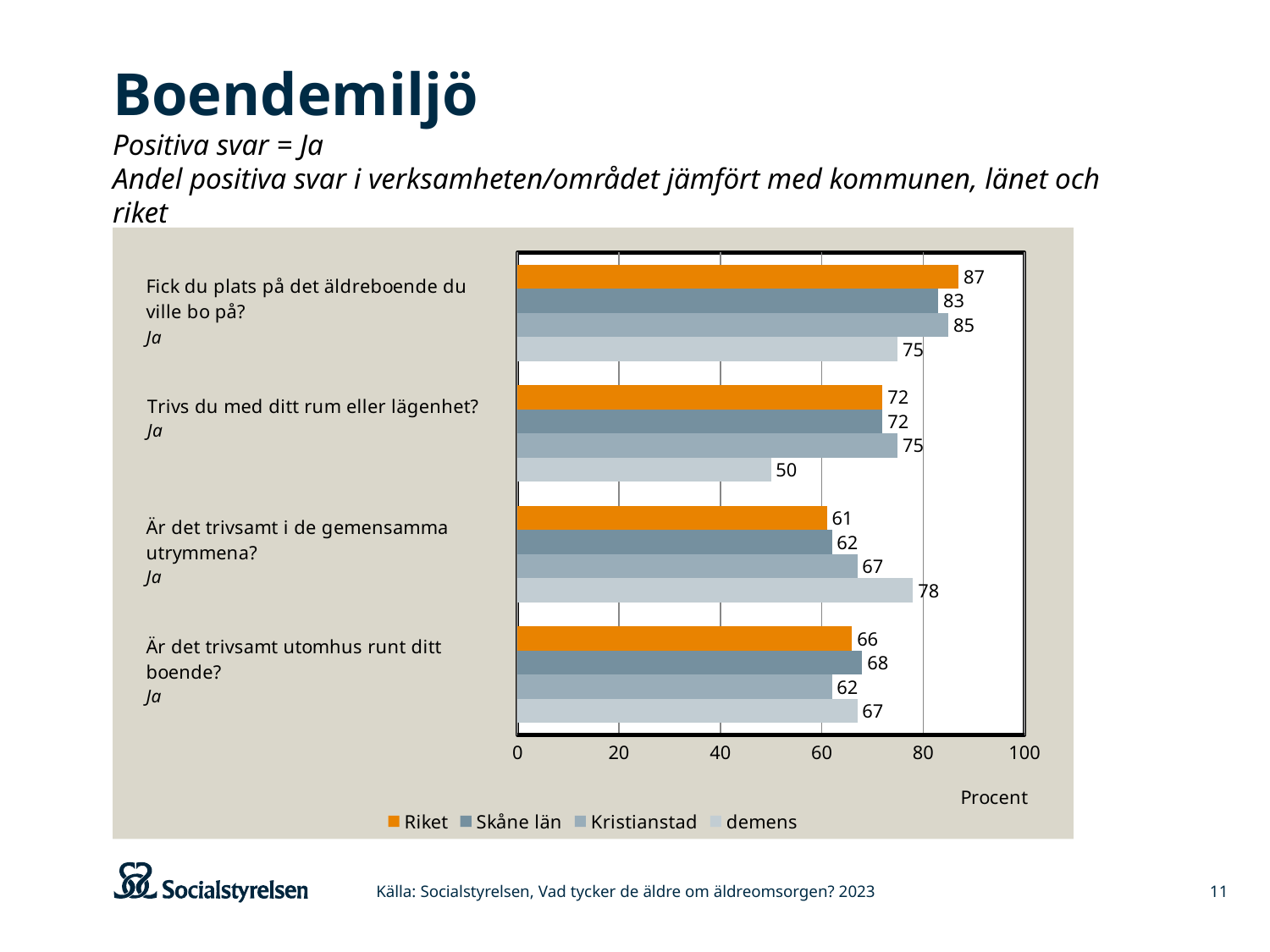
How many series does the legend list? 4 What is the value for Kristianstad for "Är det trivsamt i de gemensamma utrymmena?"? 67 What is the label on the horizontal axis of the chart? Procent How many question categories are plotted on the chart? 4 For "Är det trivsamt utomhus runt ditt boende?", which is larger: the value for Skåne län or the value for Kristianstad? Skåne län Which series has the lowest value for "Trivs du med ditt rum eller lägenhet?"? demens What kind of chart is shown on the slide? bar chart Which series has the highest value for "Är det trivsamt i de gemensamma utrymmena?"? demens What is the difference between the Riket and demens values for "Fick du plats på det äldreboende du ville bo på?"? 12 What is the value for demens for "Trivs du med ditt rum eller lägenhet?"? 50 What is the value for Riket for "Fick du plats på det äldreboende du ville bo på?"? 87 What is the value for Skåne län for "Är det trivsamt utomhus runt ditt boende?"? 68